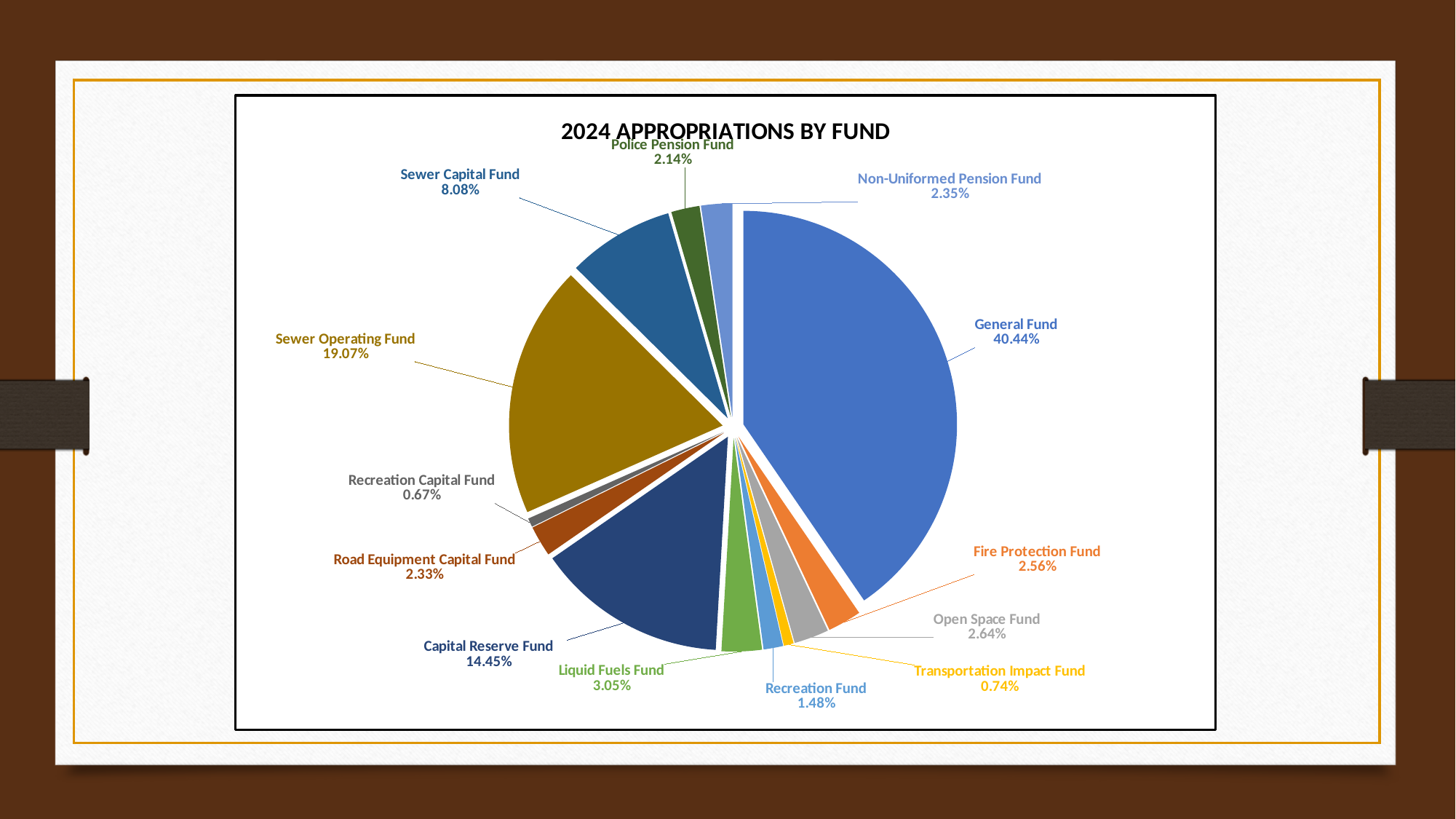
Which fund has the largest share of the pie? General Fund What is the difference in percentage points between the Sewer Operating Fund and the Capital Reserve Fund? 4.62 Which fund has the smallest share of the pie? Recreation Capital Fund What is the value shown for the Transportation Impact Fund? 0.74% What is the value shown for the Capital Reserve Fund? 14.45% How many funds (slices) are shown in the pie chart? 13 What is the difference in percentage points between the General Fund and the Sewer Operating Fund? 21.37 What share of the pie does the General Fund represent? 40.44% What is the title of the chart? 2024 APPROPRIATIONS BY FUND What type of chart is shown on the slide? Pie chart Which is larger, the Sewer Capital Fund or the Liquid Fuels Fund? Sewer Capital Fund What is the value shown for the Sewer Operating Fund? 19.07%